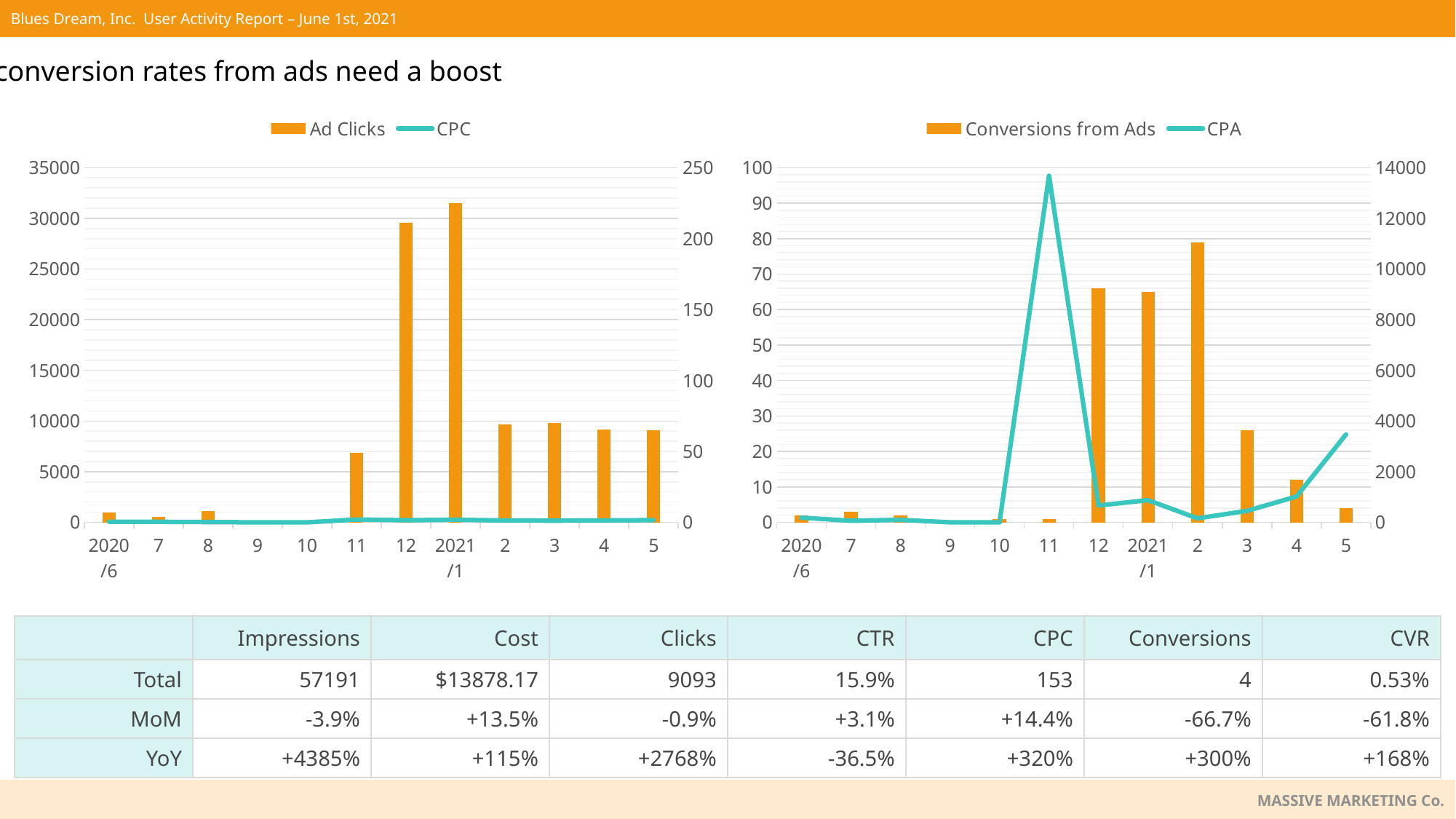
How many months are shown on the x axis of the left chart (Ad Clicks / CPC)? 12 How many series does the legend of the right chart (Conversions from Ads / CPA) list? 2 In the right chart (Conversions from Ads / CPA), is the Conversions from Ads value for 3 greater or less than 30? less In the right chart (Conversions from Ads / CPA), which month has the highest Conversions from Ads? 2 What kind of chart is the left chart (Ad Clicks / CPC)? Combination bar and line chart In the left chart (Ad Clicks / CPC), is the Ad Clicks value for 12 greater or less than 25000? greater In the left chart (Ad Clicks / CPC), which month has the highest Ad Clicks? 2021/1 In the right chart (Conversions from Ads / CPA), in which month does the CPA line peak? 11 In the right chart (Conversions from Ads / CPA), is the Conversions from Ads value for 12 greater or less than 60? greater In the left chart (Ad Clicks / CPC), which is larger, the Ad Clicks for 12 or for 2021/1? 2021/1